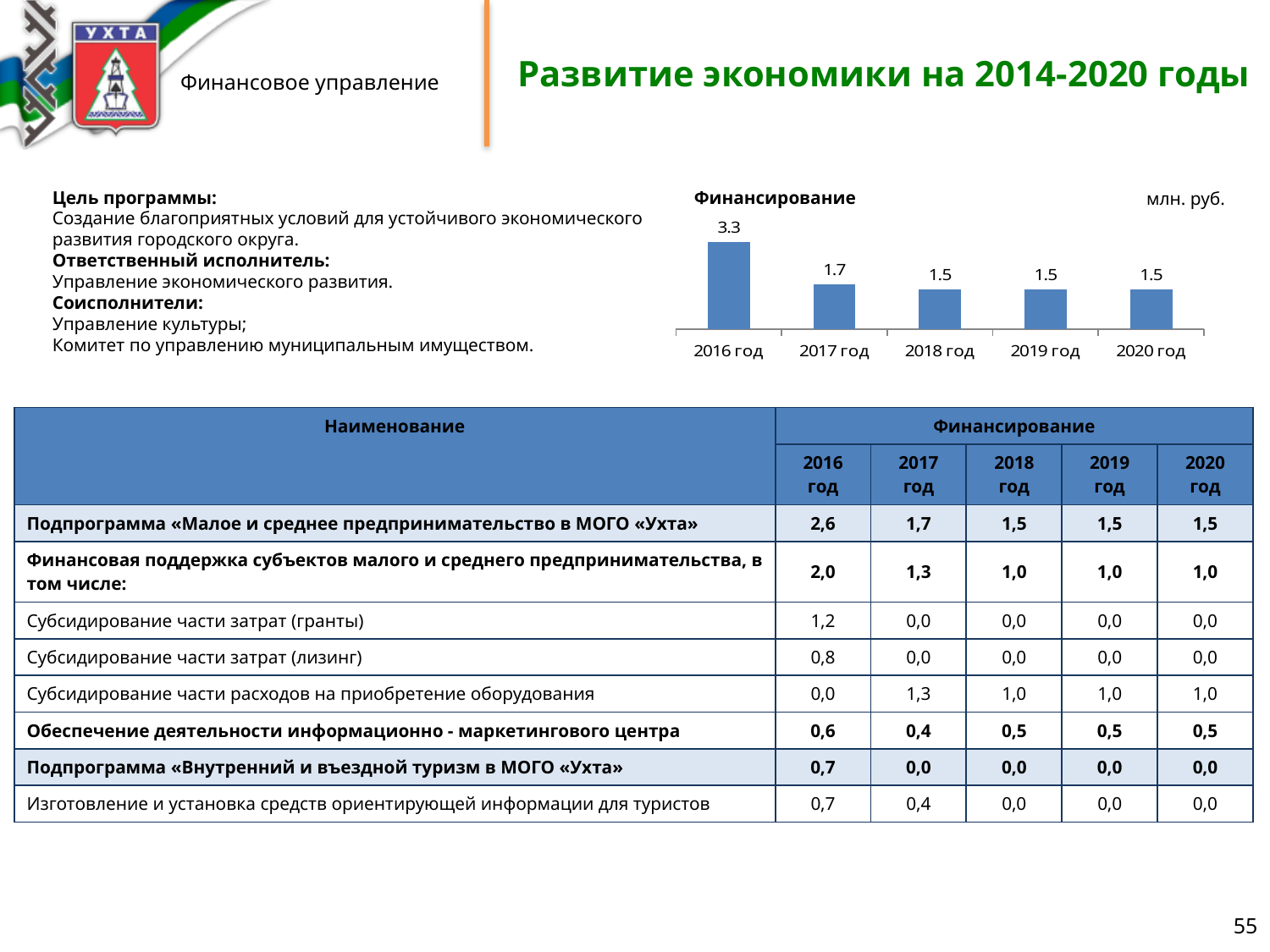
Which is larger in the Финансирование chart, the value for 2016 год or 2020 год? 2016 год What is the title of the chart on the slide? Финансирование What is the value for 2016 год in the Финансирование chart? 3.3 Do the values in the Финансирование chart rise or fall from 2016 год to 2018 год? fall What is the value for 2019 год in the Финансирование chart? 1.5 What is the difference between the values for 2016 год and 2017 год in the Финансирование chart? 1.6 Which year has the highest value in the Финансирование chart? 2016 год What is the difference between the values for 2017 год and 2018 год in the Финансирование chart? 0.2 What unit is indicated for the Финансирование chart? млн. руб. What kind of chart is the Финансирование chart? bar chart What is the value for 2017 год in the Финансирование chart? 1.7 How many years are shown in the Финансирование chart? 5